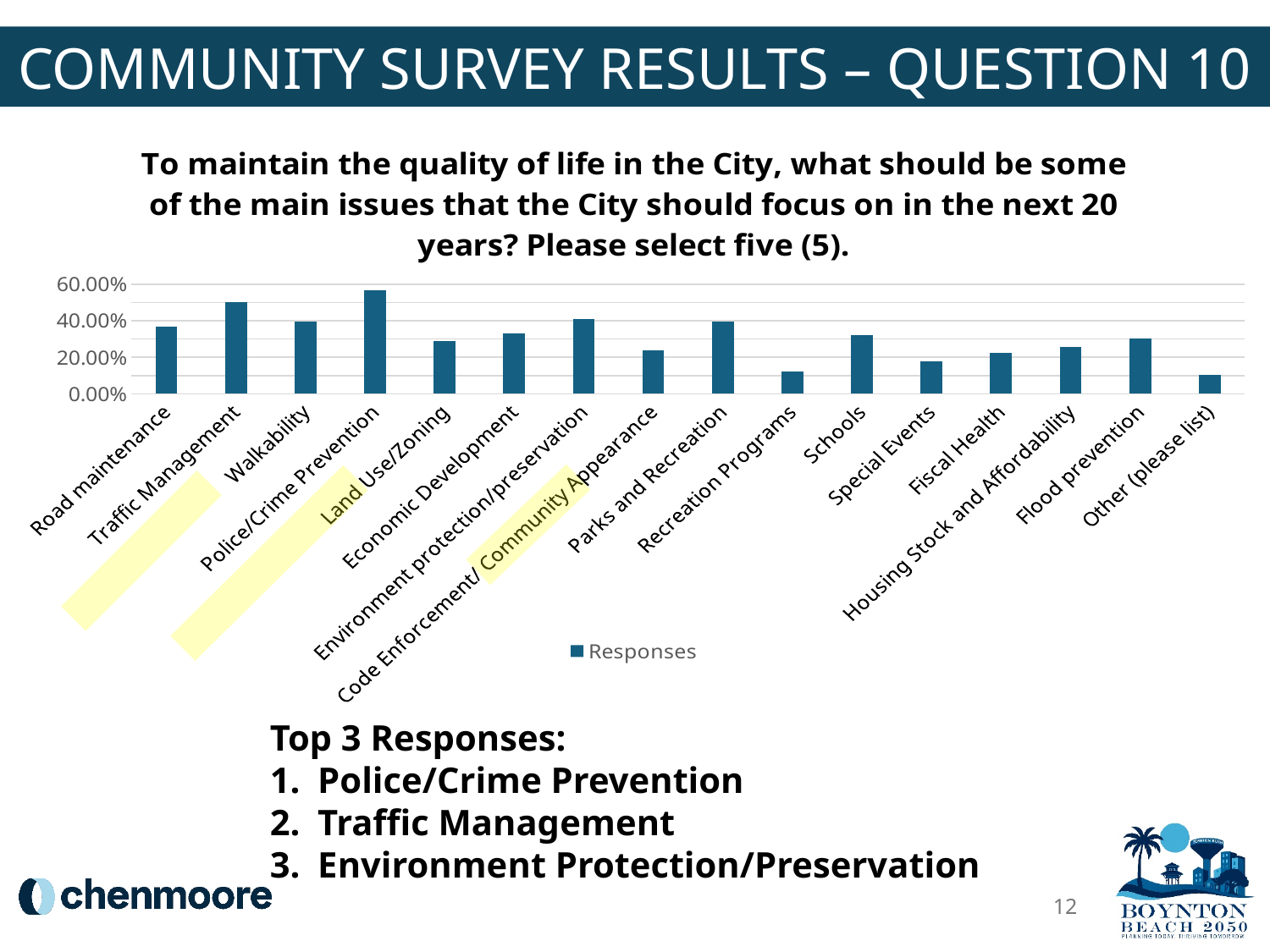
Which has the larger value, Traffic Management or Walkability? Traffic Management How many categories are plotted on the x axis of the chart? 16 Which has the larger value, Schools or Special Events? Schools What kind of chart is shown on the slide? bar chart What is the name of the series shown in the chart's legend? Responses Is the value for Special Events greater or less than 20.00%? less How many series does the chart's legend list? 1 Is the value for Traffic Management greater or less than 40.00%? greater Which has the larger value, Police/Crime Prevention or Environment protection/preservation? Police/Crime Prevention Is the value for Land Use/Zoning greater or less than 20.00%? greater Which category has the highest value in the chart? Police/Crime Prevention